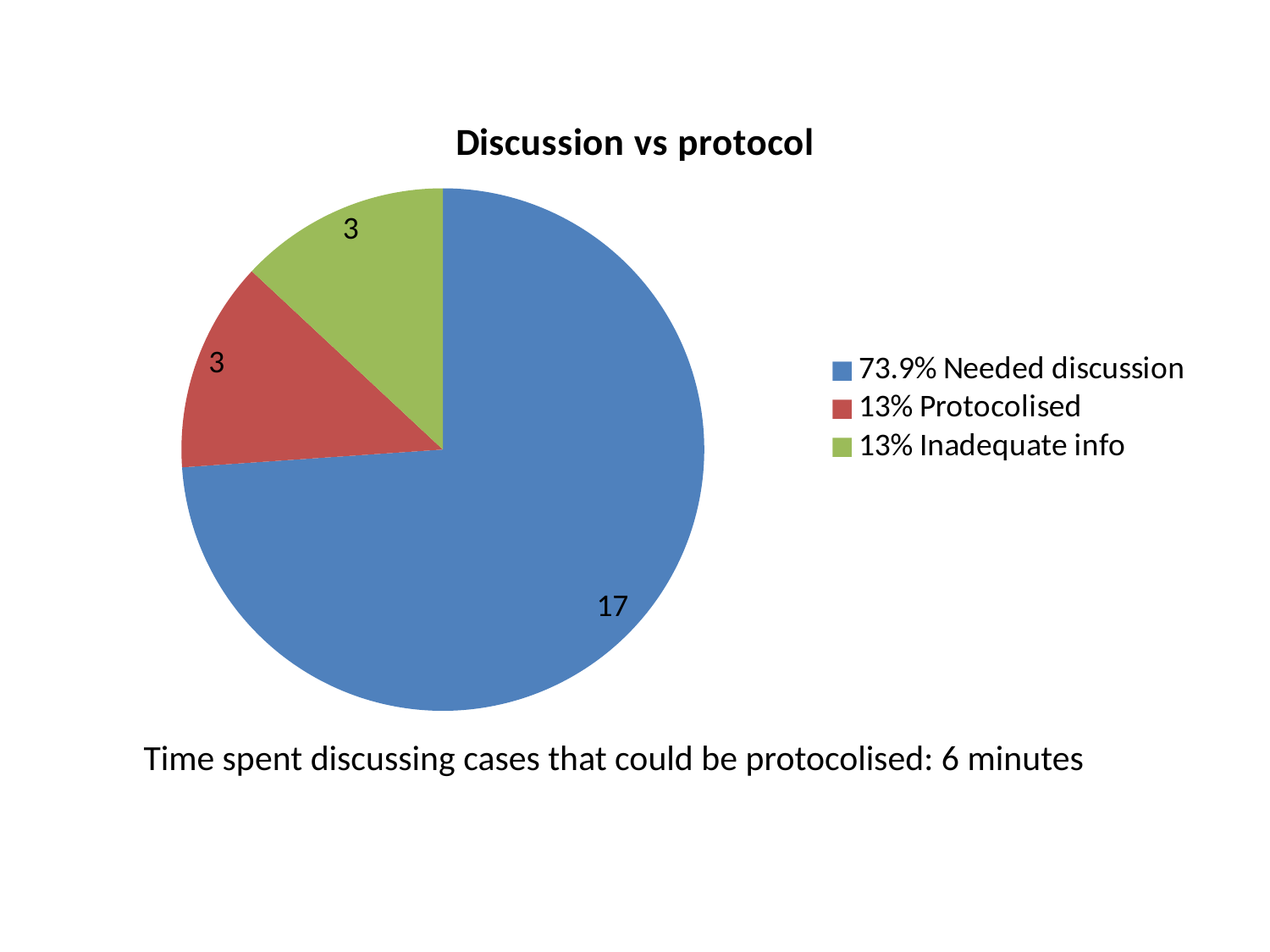
What share of the pie does 'Inadequate info' represent, as shown in the legend? 13% Which colour represents 'Protocolised' in the chart? red Which category has the largest slice? Needed discussion How many slices does the pie chart have? 3 What is the value of the 'Protocolised' slice? 3 What share of the pie does 'Needed discussion' represent, as shown in the legend? 73.9% What is the value of the 'Needed discussion' slice? 17 What is the total of all slices in the pie chart? 23 What is the difference between the 'Needed discussion' value and the 'Protocolised' value? 14 What kind of chart is shown on the slide? pie chart What is the value of the 'Inadequate info' slice? 3 What is the title of the chart? Discussion vs protocol